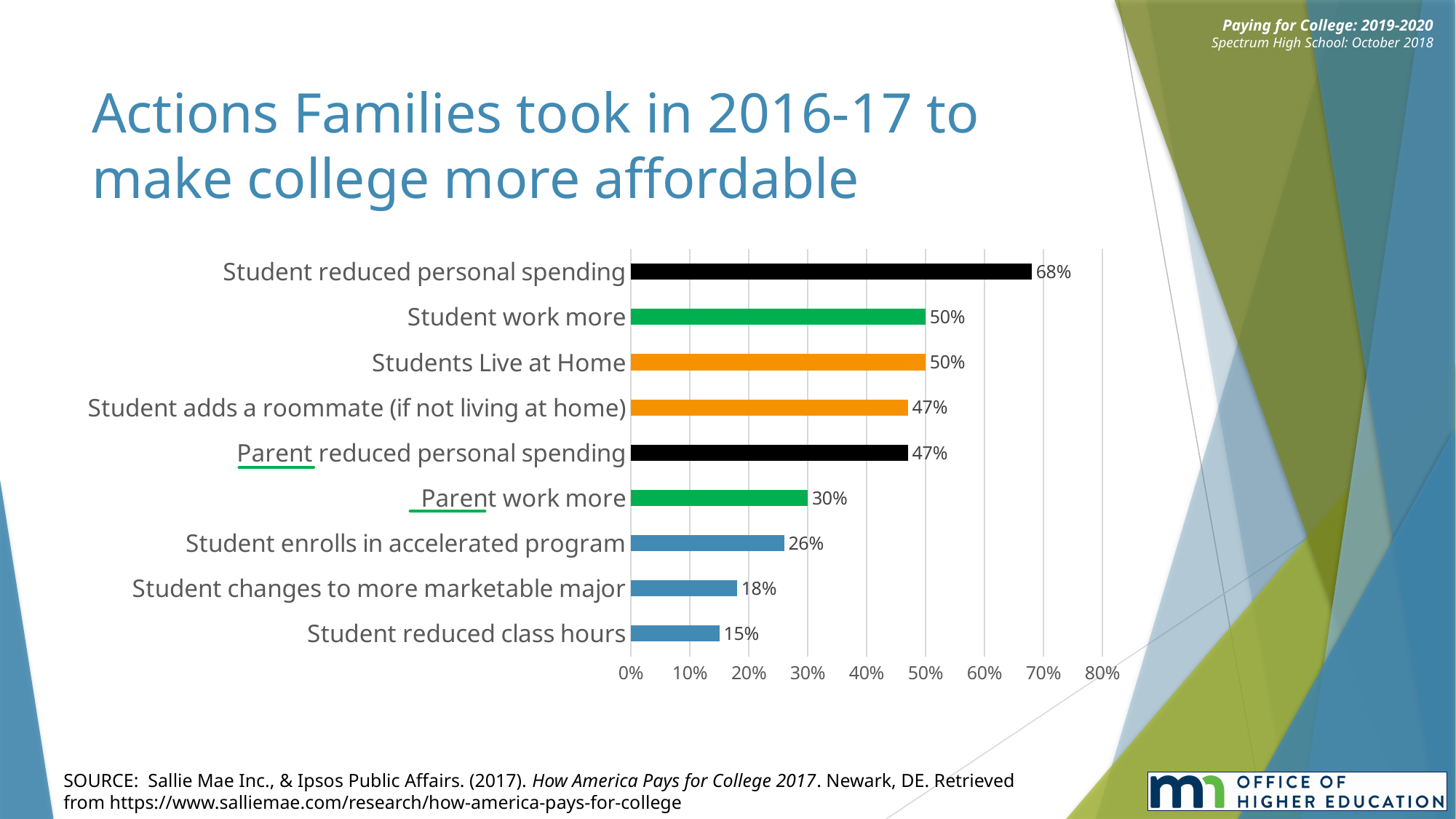
What is the difference between 'Parent work more' and 'Student reduced class hours'? 15% Which is larger: 'Student enrolls in accelerated program' or 'Parent work more'? Parent work more What is the difference between 'Student reduced personal spending' and 'Student work more'? 18% What percentage of families reported that the student reduced personal spending? 68% Which action has the lowest percentage? Student reduced class hours What colour is the bar for 'Students Live at Home'? Orange What type of chart is shown on the slide? Bar chart How many actions are shown in the chart? 9 What is the value for 'Parent work more'? 30% Which action has the highest percentage? Student reduced personal spending Is the value for 'Student adds a roommate (if not living at home)' greater or less than 40%? greater What is the value for 'Student changes to more marketable major'? 18%